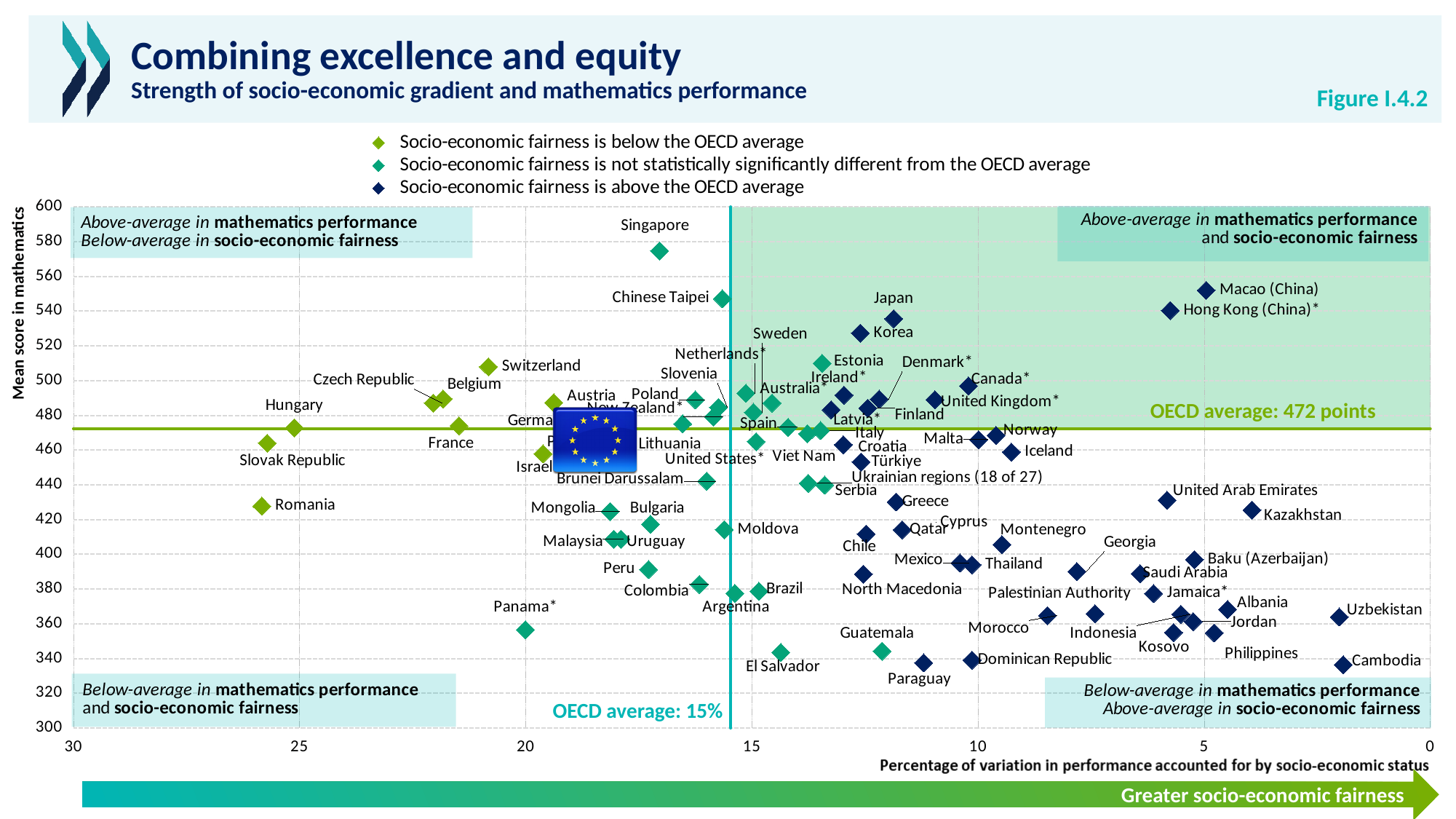
Is the mean score in mathematics for Singapore greater or less than 560? greater Which country has the highest mean score in mathematics? Singapore Is the mean score in mathematics for Romania greater or less than 440? less Which has the higher mean score in mathematics, Switzerland or Romania? Switzerland What is the OECD average percentage of variation in performance accounted for by socio-economic status shown on the chart? 15% What kind of chart is shown on the slide? Scatter chart Is the mean score in mathematics for Uzbekistan greater or less than 380? less How many series does the legend list? 3 What is the OECD average mean score in mathematics shown on the chart? 472 points What is the label of the horizontal axis? Percentage of variation in performance accounted for by socio-economic status Which has the higher mean score in mathematics, Singapore or Japan? Singapore